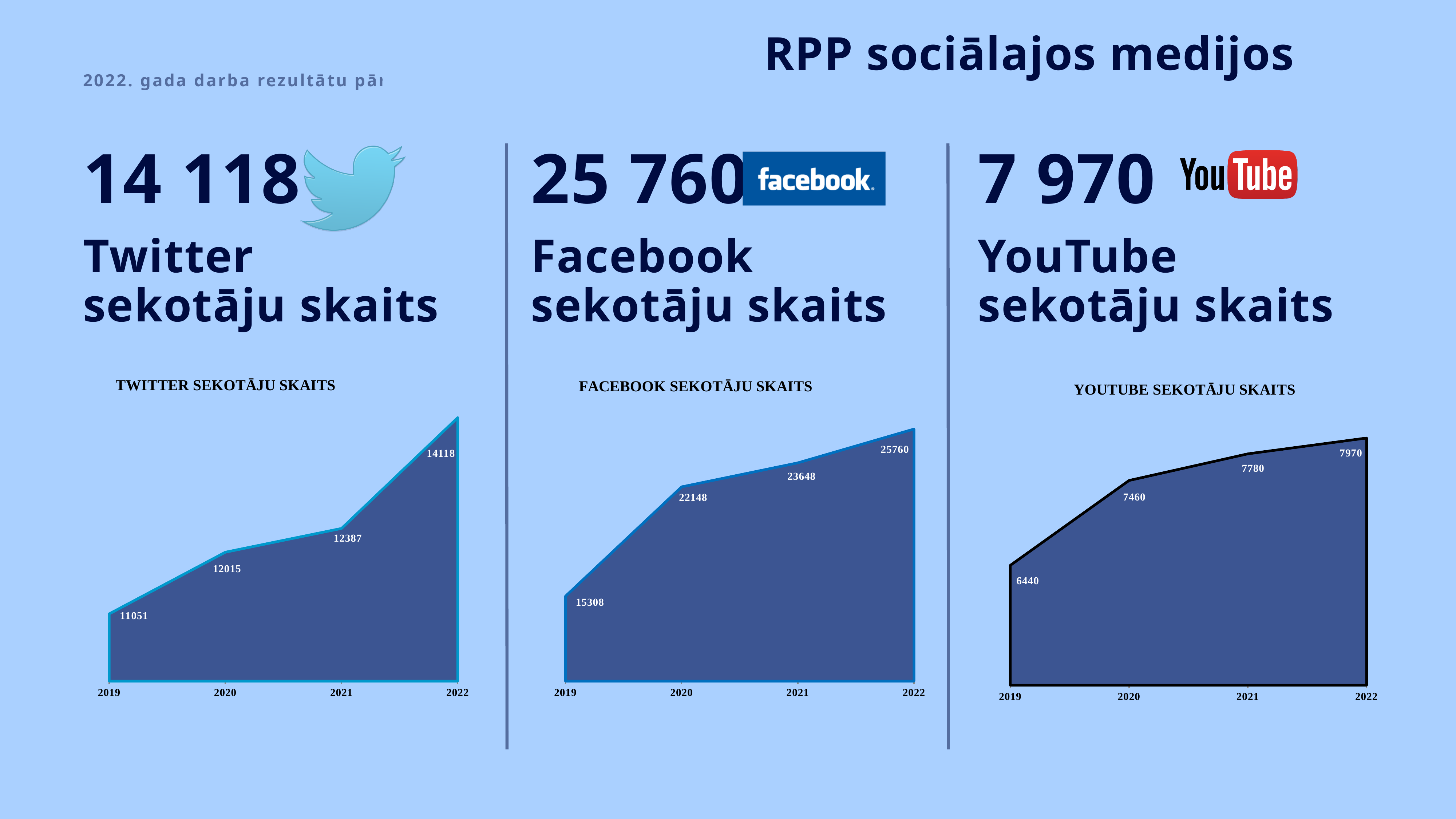
What kind of chart is the YOUTUBE SEKOTĀJU SKAITS chart? area chart In the TWITTER SEKOTĀJU SKAITS chart, what is the value for 2021? 12387 In the FACEBOOK SEKOTĀJU SKAITS chart, what is the difference between the 2022 and 2021 values? 2112 How many years are plotted in the FACEBOOK SEKOTĀJU SKAITS chart? 4 How many charts are shown on the slide? 3 In the YOUTUBE SEKOTĀJU SKAITS chart, which year has the lowest value? 2019 In the TWITTER SEKOTĀJU SKAITS chart, what is the difference between the 2020 and 2019 values? 964 In the YOUTUBE SEKOTĀJU SKAITS chart, what is the value for 2020? 7460 In the FACEBOOK SEKOTĀJU SKAITS chart, do the values rise or fall from 2019 to 2022? rise In the TWITTER SEKOTĀJU SKAITS chart, which year has the highest value? 2022 In the YOUTUBE SEKOTĀJU SKAITS chart, which is larger, the value for 2021 or the value for 2022? 2022 In the FACEBOOK SEKOTĀJU SKAITS chart, what is the value for 2019? 15308